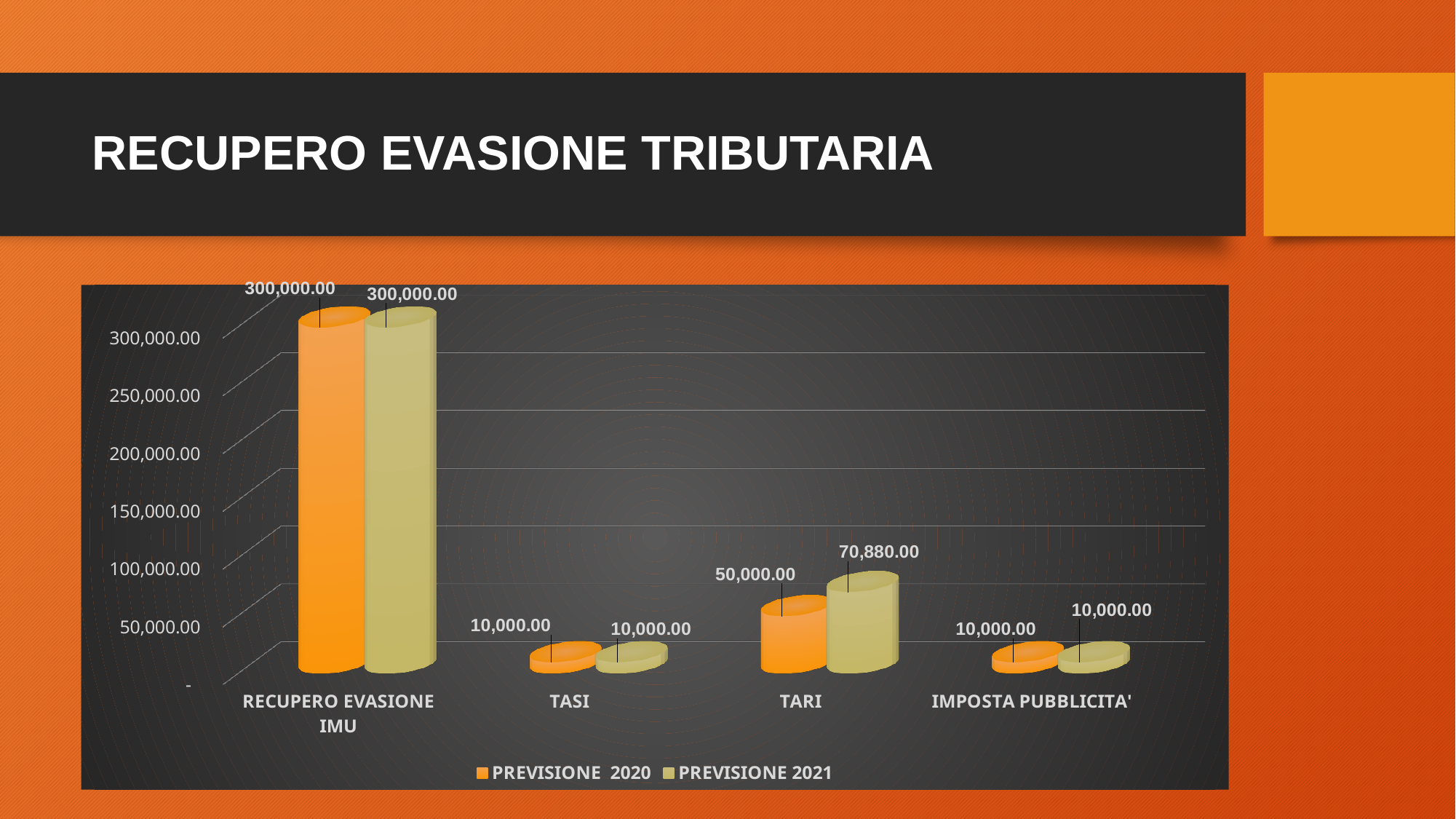
What is the PREVISIONE 2020 value for RECUPERO EVASIONE IMU? 300,000.00 How many series does the legend list? 2 Is the PREVISIONE 2020 value for TARI greater or less than 100,000.00? less What is the title of the slide? RECUPERO EVASIONE TRIBUTARIA Which is larger for TARI: the PREVISIONE 2020 value or the PREVISIONE 2021 value? PREVISIONE 2021 What is the PREVISIONE 2021 value for TARI? 70,880.00 What kind of chart is shown on the slide? bar chart What is the PREVISIONE 2021 value for IMPOSTA PUBBLICITA'? 10,000.00 Which category has the highest PREVISIONE 2021 value? RECUPERO EVASIONE IMU How many categories are shown on the x axis? 4 What is the difference between the PREVISIONE 2021 and PREVISIONE 2020 values for TARI? 20,880.00 What is the PREVISIONE 2020 value for TASI? 10,000.00